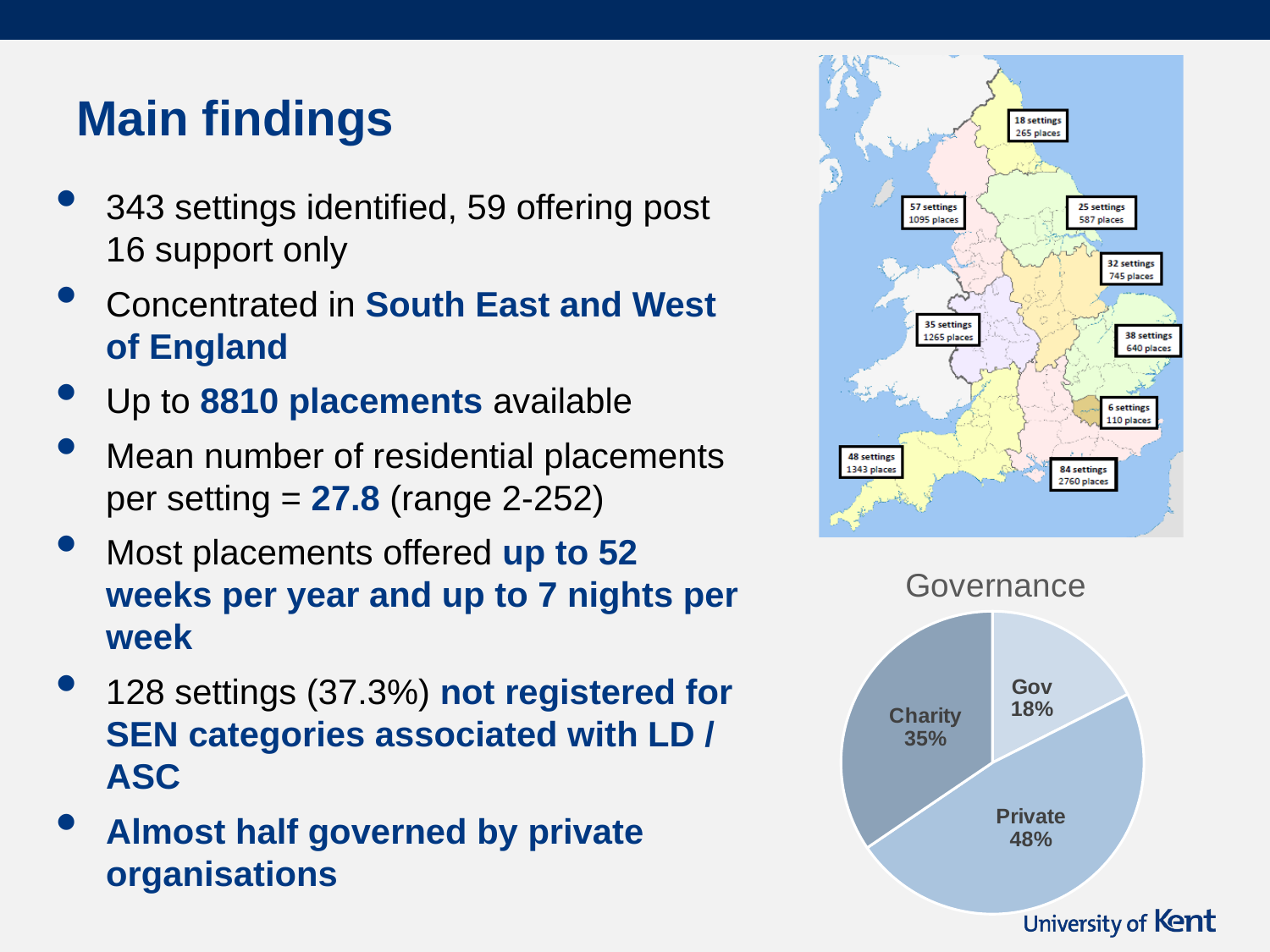
What share of the Governance pie does the Private slice represent? 48% How many slices does the Governance pie chart have? 3 In the Governance pie chart, what percentage is shown for Gov? 18% In the Governance pie chart, what percentage is shown for Private? 48% In the Governance pie chart, what is the difference in percentage points between Charity and Gov? 17 In the Governance pie chart, what percentage is shown for Charity? 35% What is the title of the pie chart on the slide? Governance In the Governance pie chart, what is the difference in percentage points between Private and Charity? 13 Which category has the largest slice in the Governance pie chart? Private Which category has the smallest slice in the Governance pie chart? Gov In the Governance pie chart, which is larger, Charity or Gov? Charity What type of chart is the Governance chart? pie chart